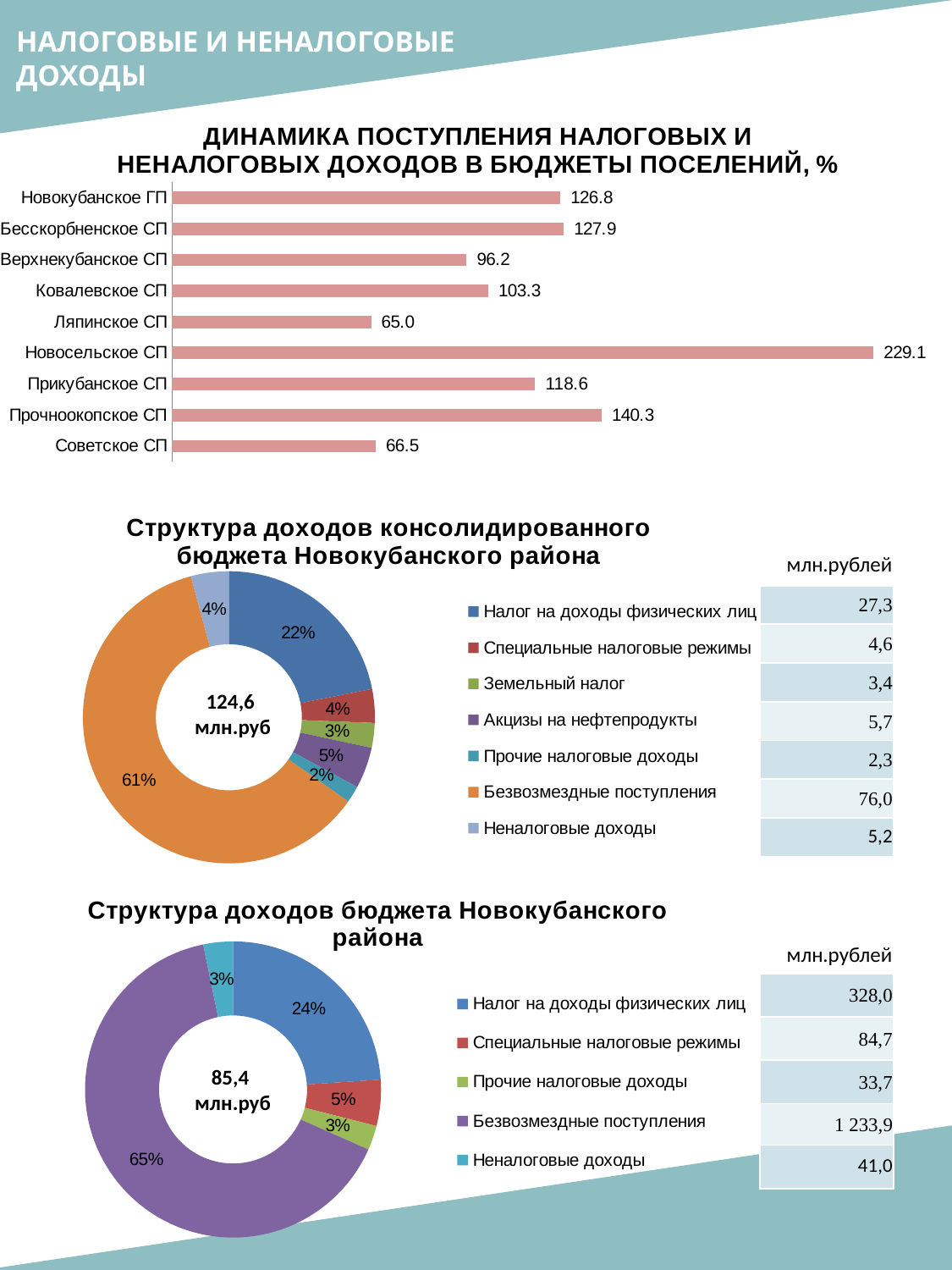
In the bar chart 'Динамика поступления налоговых и неналоговых доходов в бюджеты поселений, %', what is the value for Новосельское СП? 229.1 In the doughnut chart 'Структура доходов консолидированного бюджета Новокубанского района', what share is Безвозмездные поступления? 61% What total is shown in the centre of the doughnut chart 'Структура доходов бюджета Новокубанского района'? 85,4 млн.руб In the bar chart 'Динамика поступления налоговых и неналоговых доходов в бюджеты поселений, %', what is the difference between Прочноокопское СП and Советское СП? 73.8 In the bar chart 'Динамика поступления налоговых и неналоговых доходов в бюджеты поселений, %', which settlement has the highest value? Новосельское СП How many categories does the legend list in the doughnut chart 'Структура доходов консолидированного бюджета Новокубанского района'? 7 In the doughnut chart 'Структура доходов бюджета Новокубанского района', what share is Налог на доходы физических лиц? 24% How many settlements are shown in the bar chart 'Динамика поступления налоговых и неналоговых доходов в бюджеты поселений, %'? 9 What type of chart is 'Динамика поступления налоговых и неналоговых доходов в бюджеты поселений, %'? Bar chart In the bar chart 'Динамика поступления налоговых и неналоговых доходов в бюджеты поселений, %', which is larger: Ковалевское СП or Верхнекубанское СП? Ковалевское СП In the doughnut chart 'Структура доходов консолидированного бюджета Новокубанского района', what is the value in млн.рублей for Налог на доходы физических лиц? 27,3 In the bar chart 'Динамика поступления налоговых и неналоговых доходов в бюджеты поселений, %', which settlement has the lowest value? Ляпинское СП